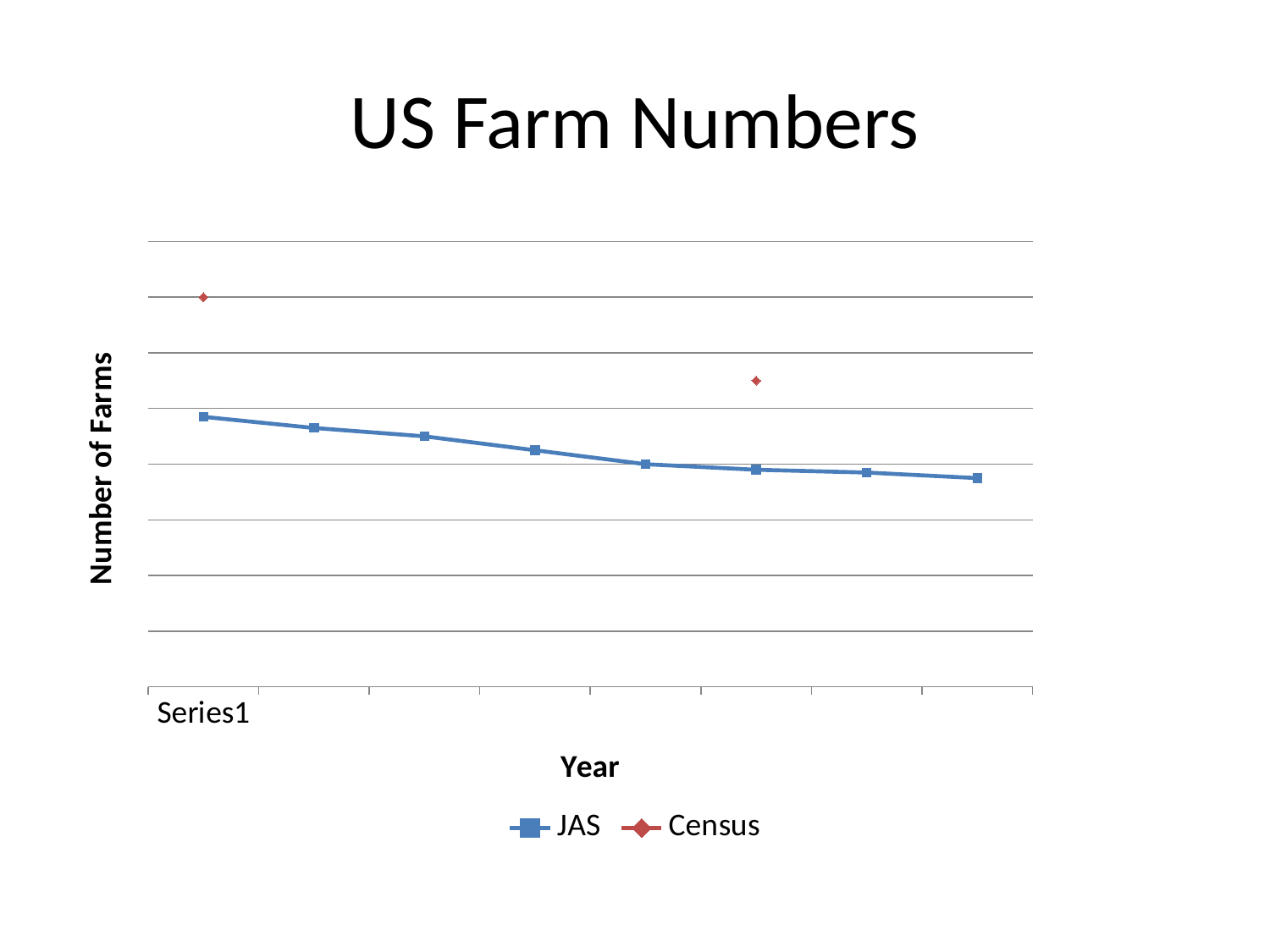
How many series does the legend list? 2 How many data points are plotted for the Census series? 2 How many data points are plotted for the JAS series? 8 Which series is plotted as a connected line, JAS or Census? JAS What kind of chart is shown on the slide? line chart Do the JAS values rise or fall along the x axis? fall What is the title of the chart? US Farm Numbers Which series has the higher plotted values, JAS or Census? Census